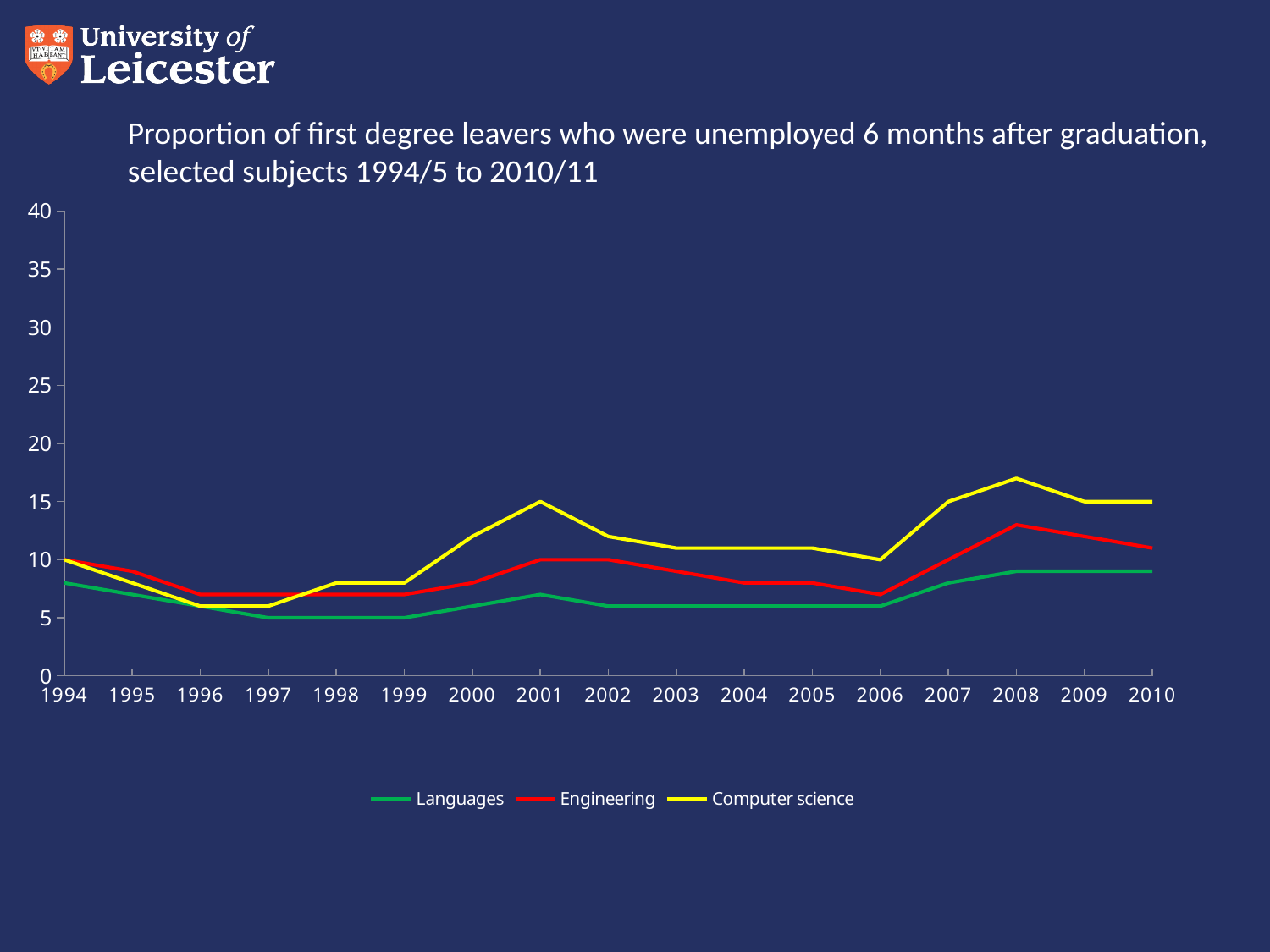
How many series does the legend list? 3 In which year does the Computer science line reach its highest value? 2008 What is the value for Languages in 1997? 5 Which series has the lowest value in 2010? Languages Does the Computer science line rise or fall between 2006 and 2008? rise Is the value for Languages in 2001 greater or less than 10? less How many years are plotted along the x axis? 17 What is the value for Computer science in 2001? 15 Is the value for Computer science in 2008 greater or less than 15? greater What colour is the Computer science line? yellow What kind of chart is shown on the slide? line chart In 2008, which is larger: Computer science or Languages? Computer science